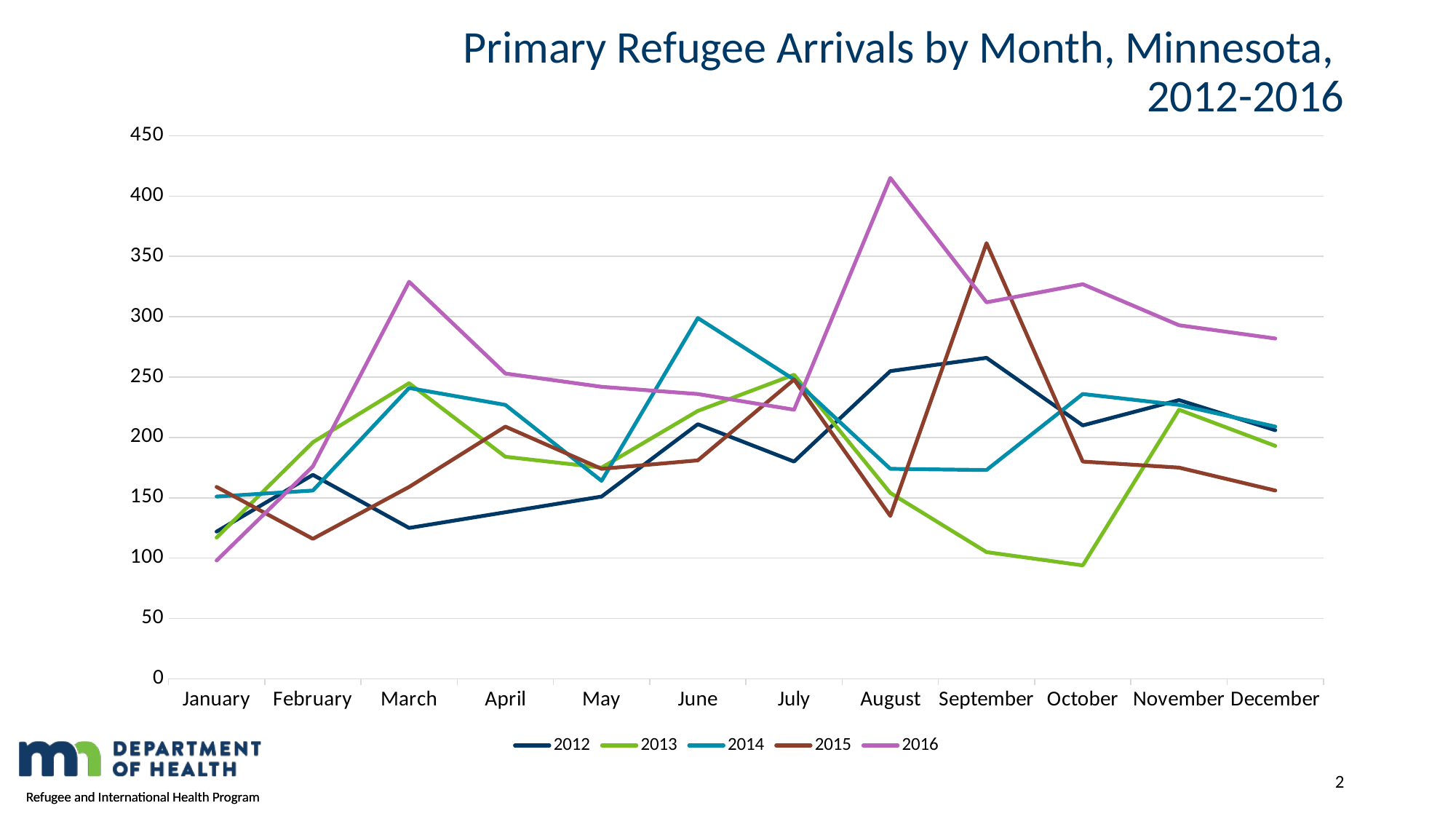
In which month does the 2016 series reach its highest value? August In August, which series has the larger value, 2016 or 2015? 2016 How many months are shown along the x axis? 12 In which month does the 2014 series reach its highest value? June How many series does the legend list? 5 Is the value for 2015 in September greater or less than 350? greater What is the title of the chart? Primary Refugee Arrivals by Month, Minnesota, 2012-2016 Does the 2016 series rise or fall from August to December? fall Is the value for 2016 in August greater or less than 400? greater Is the value for 2012 in March greater or less than 150? less In which month does the 2015 series reach its highest value? September What kind of chart is shown on the slide? line chart